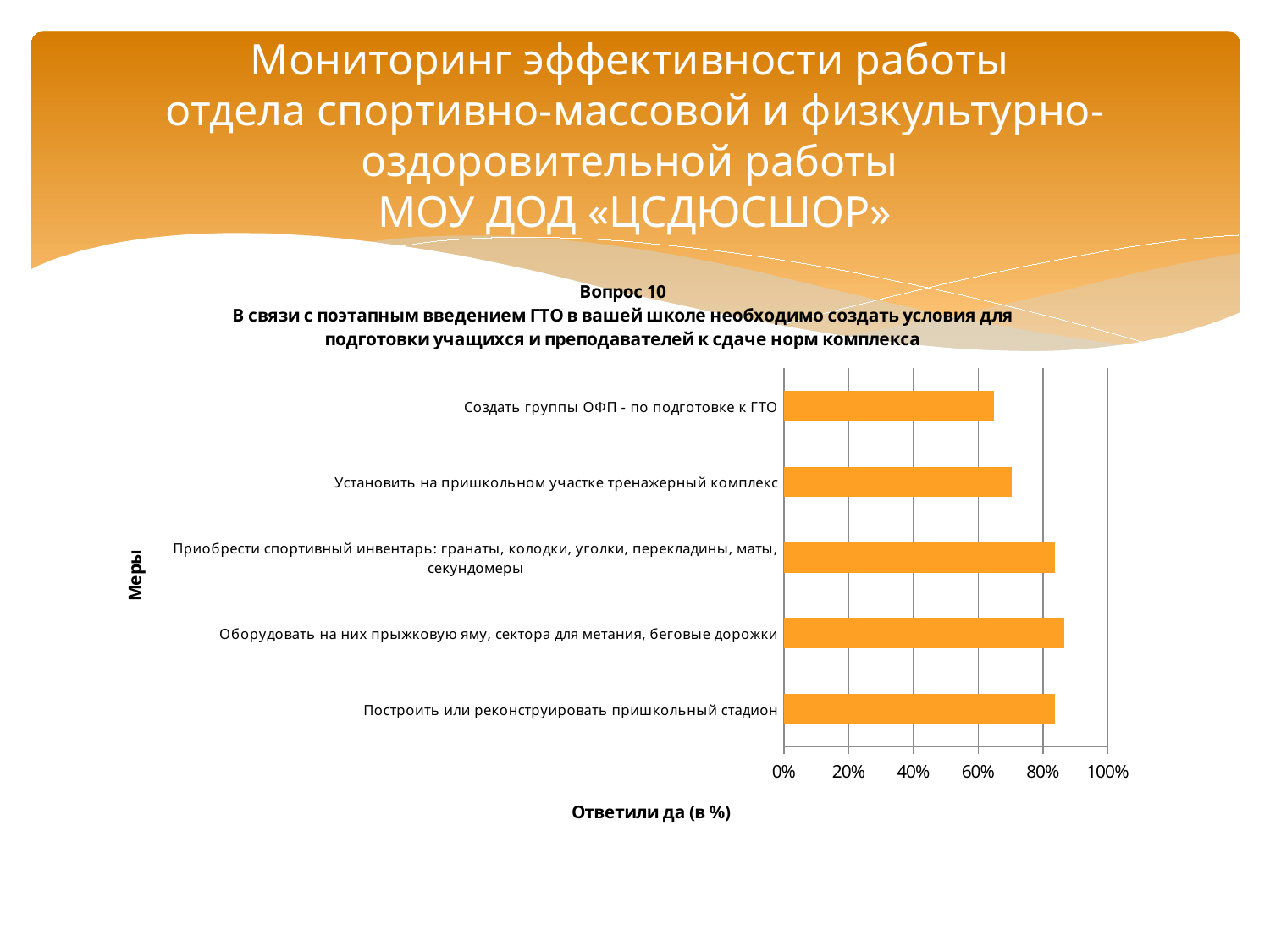
Which is larger: the value for 'Установить на пришкольном участке тренажерный комплекс' or for 'Создать группы ОФП - по подготовке к ГТО'? Установить на пришкольном участке тренажерный комплекс Is the value for 'Построить или реконструировать пришкольный стадион' greater or less than 80%? greater Which is larger: the value for 'Приобрести спортивный инвентарь: гранаты, колодки, уголки, перекладины, маты, секундомеры' or for 'Создать группы ОФП - по подготовке к ГТО'? Приобрести спортивный инвентарь: гранаты, колодки, уголки, перекладины, маты, секундомеры Is the value for 'Установить на пришкольном участке тренажерный комплекс' greater or less than 80%? less What is the title of the horizontal axis of the chart? Ответили да (в %) Which measure has the lowest share of 'yes' answers? Создать группы ОФП - по подготовке к ГТО Is the value for 'Оборудовать на них прыжковую яму, сектора для метания, беговые дорожки' greater or less than 80%? greater What is the title of the vertical axis of the chart? Меры What kind of chart is shown on the slide? bar chart How many measures (categories) are plotted in the chart? 5